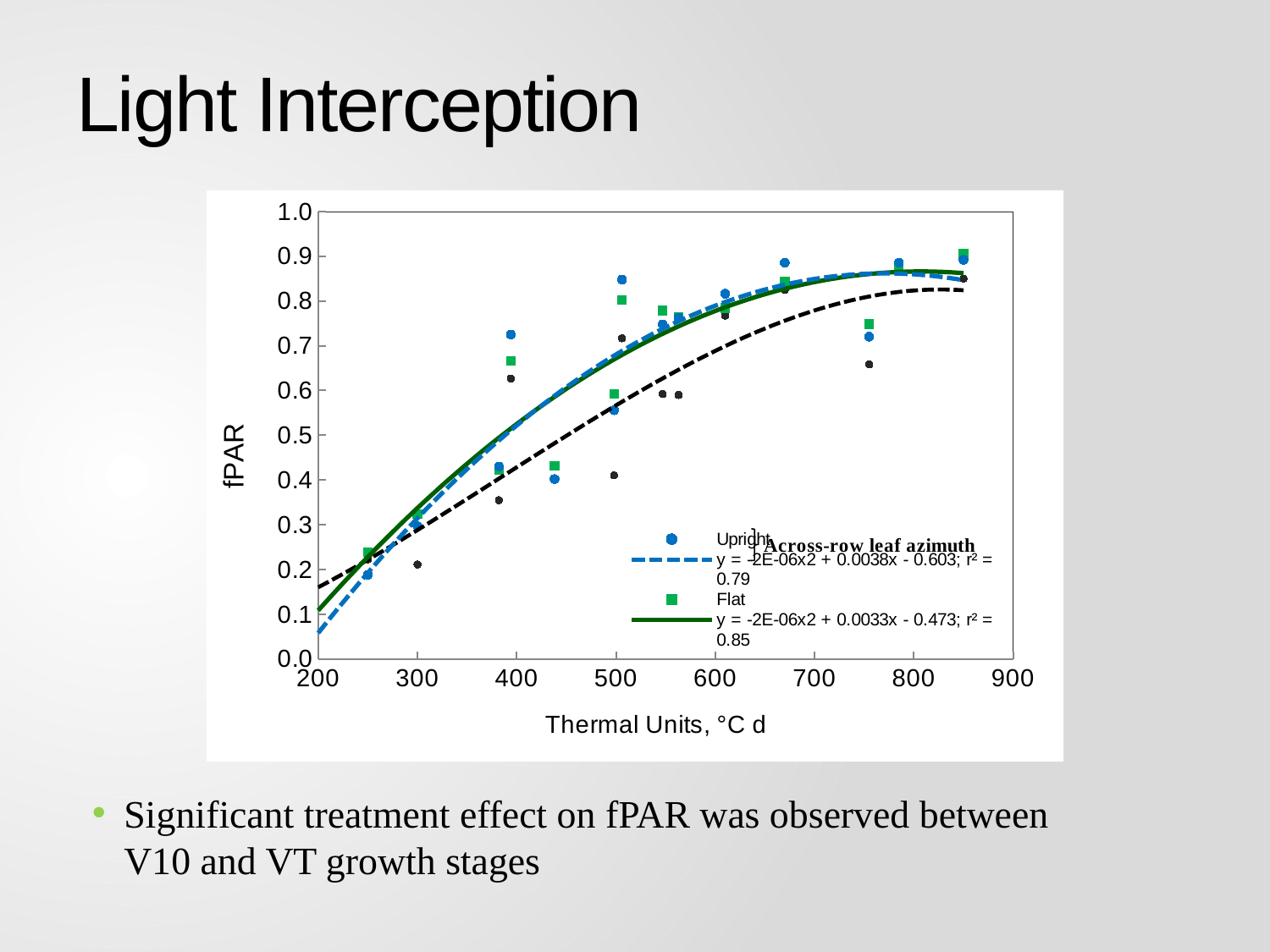
Is the Upright fPAR value at about 670 thermal units greater or less than 0.8? greater Which trendline has the higher r², Upright or Flat? Flat Does fPAR generally rise or fall as thermal units increase? rise What equation is given for the Upright trendline? y = -2E-06x2 + 0.0038x - 0.603 What r² value is given for the Flat trendline? 0.85 What is the title of the y axis? fPAR What is the difference between the r² values of the Flat and Upright trendlines? 0.06 What is the highest value shown on the x axis? 900 What r² value is given for the Upright trendline? 0.79 Is the Flat fPAR value at about 300 thermal units greater or less than 0.5? less What kind of chart is shown on the slide? scatter chart What is the title of the x axis? Thermal Units, °C d